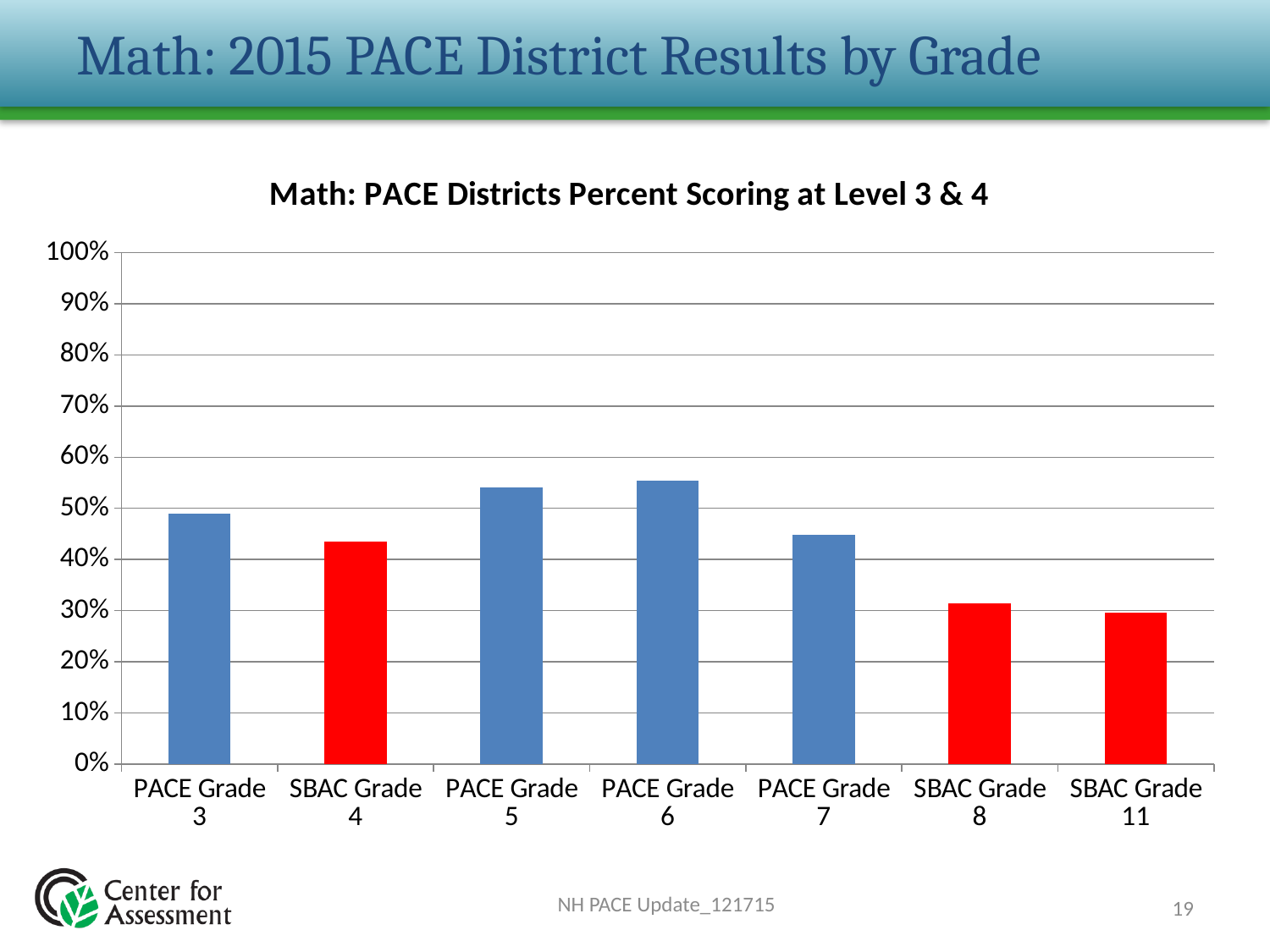
What is the title of the chart? Math: PACE Districts Percent Scoring at Level 3 & 4 Which is larger, the value for PACE Grade 5 or the value for PACE Grade 7? PACE Grade 5 What colour are the SBAC grade bars? red Is the value for SBAC Grade 11 greater or less than 40%? less How many grade categories are shown on the x axis? 7 What kind of chart is shown on the slide? bar chart Is the value for PACE Grade 3 greater or less than 40%? greater Is the value for SBAC Grade 8 greater or less than 40%? less Which is larger, the value for PACE Grade 3 or the value for SBAC Grade 4? PACE Grade 3